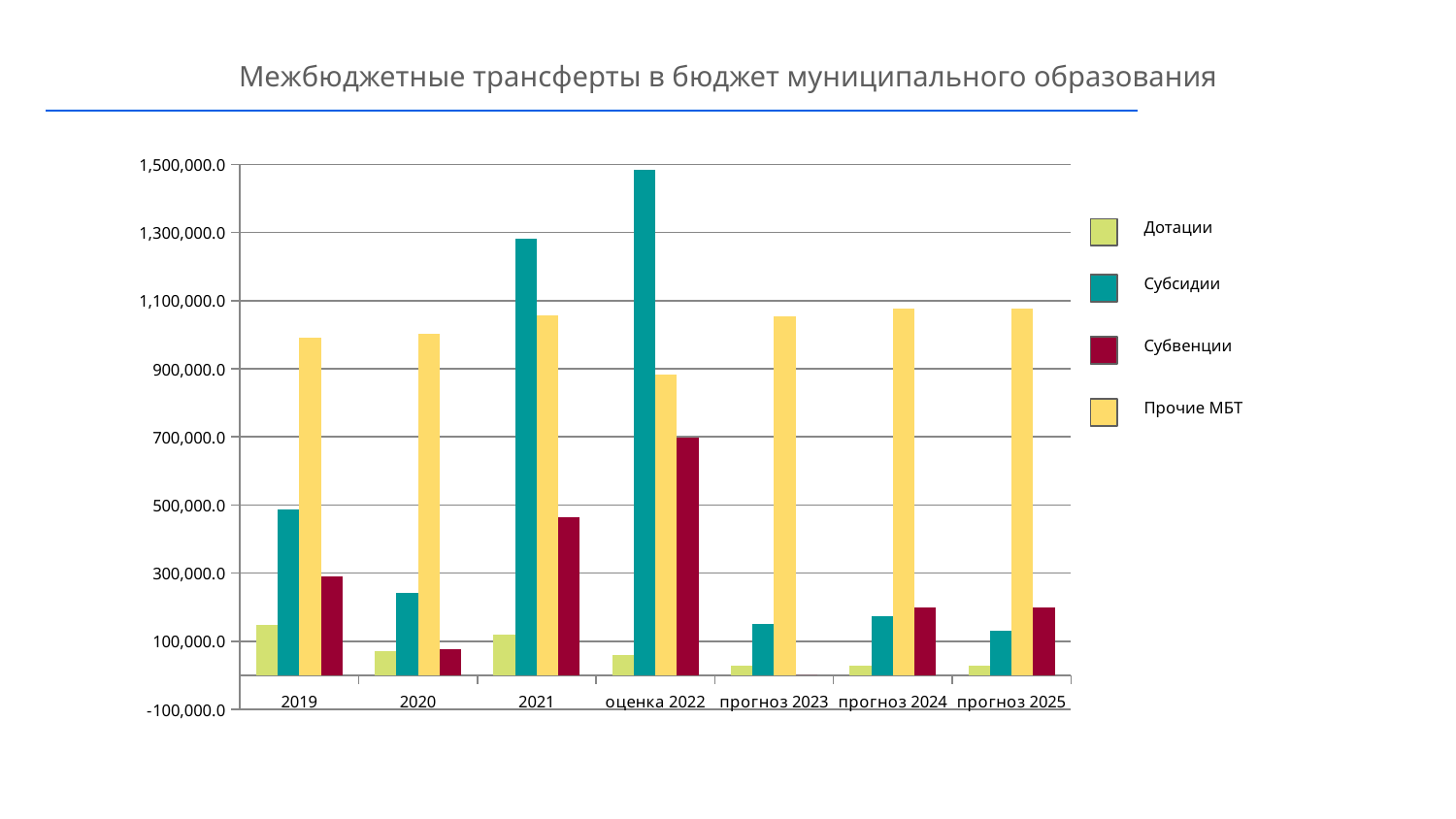
Is the value for Субвенции in оценка 2022 greater or less than 500,000.0? greater Is the value for Дотации in 2019 greater or less than 300,000.0? less Is the value for Субсидии in 2021 greater or less than 1,100,000.0? greater What is the title of the chart? Межбюджетные трансферты в бюджет муниципального образования In 2019, which is larger: Субсидии or Субвенции? Субсидии In which category is the value for Субсидии the highest? оценка 2022 How many series does the legend list? 4 What kind of chart is shown on the slide? bar chart In which category is the value for Прочие МБТ the lowest? оценка 2022 In 2020, which is larger: Субсидии or Дотации? Субсидии How many categories are shown along the x axis? 7